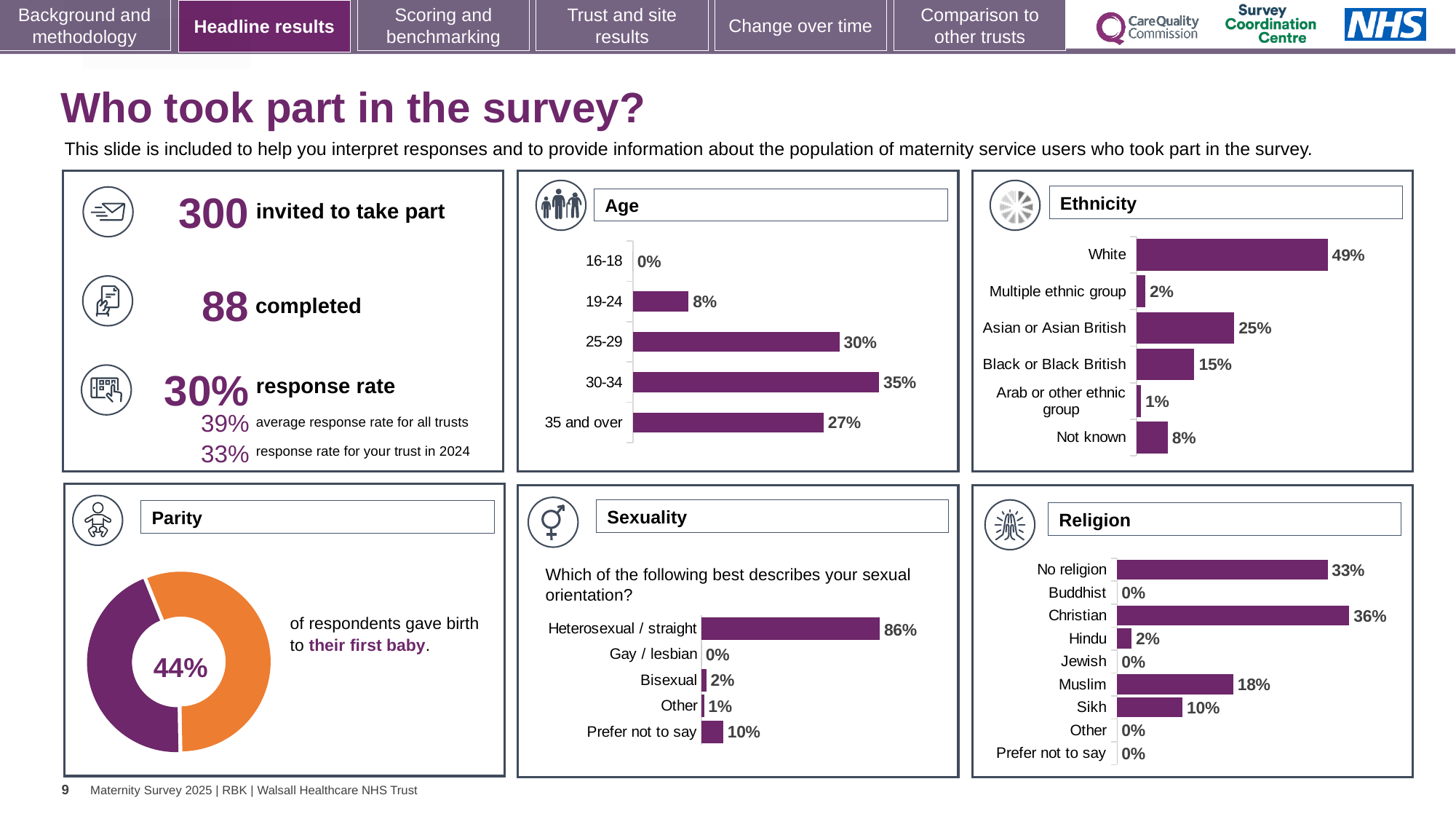
In the Age chart, what is the difference between the 25-29 and 19-24 percentages? 22% In the Ethnicity chart, what percentage of respondents were Asian or Asian British? 25% In the Sexuality chart, which is larger, Bisexual or Other? Bisexual In the Ethnicity chart, which category has the highest percentage? White In the Religion chart, what is the difference between Christian and Muslim? 18% In the Religion chart, how many categories are shown? 9 In the Age chart, which age group has the highest percentage? 30-34 In the Age chart, what percentage of respondents were aged 30-34? 35% In the Parity chart, what percentage of respondents gave birth to their first baby? 44% In the Ethnicity chart, how many categories are shown? 6 In the Sexuality chart, what percentage of respondents answered Prefer not to say? 10% What kind of chart is the Parity chart? Doughnut chart